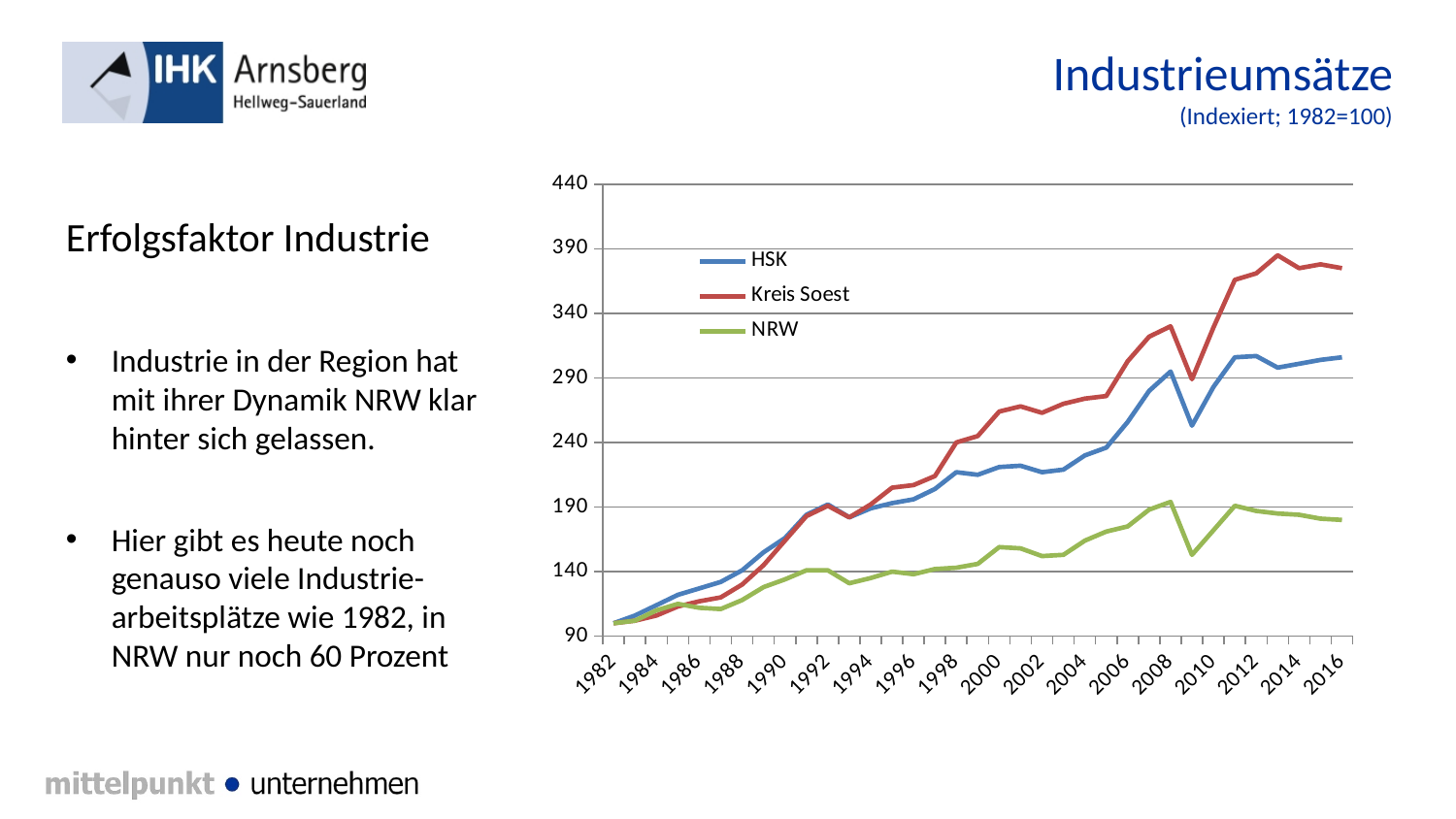
Overall, does the NRW line rise or fall from 1982 to 2016? rise Which series are listed in the chart legend? HSK, Kreis Soest, NRW Is the value for NRW in 2016 greater or less than 190? less Which series has the lowest value in 2016? NRW Is the value for HSK in 2016 greater or less than 290? greater How many series does the chart legend list? 3 Is the value for Kreis Soest in 2016 greater or less than 340? greater In 2016, which series has the higher value, HSK or NRW? HSK What is the title of the chart? Industrieumsätze What kind of chart is shown on the slide? line chart Which series has the highest value in 2016? Kreis Soest